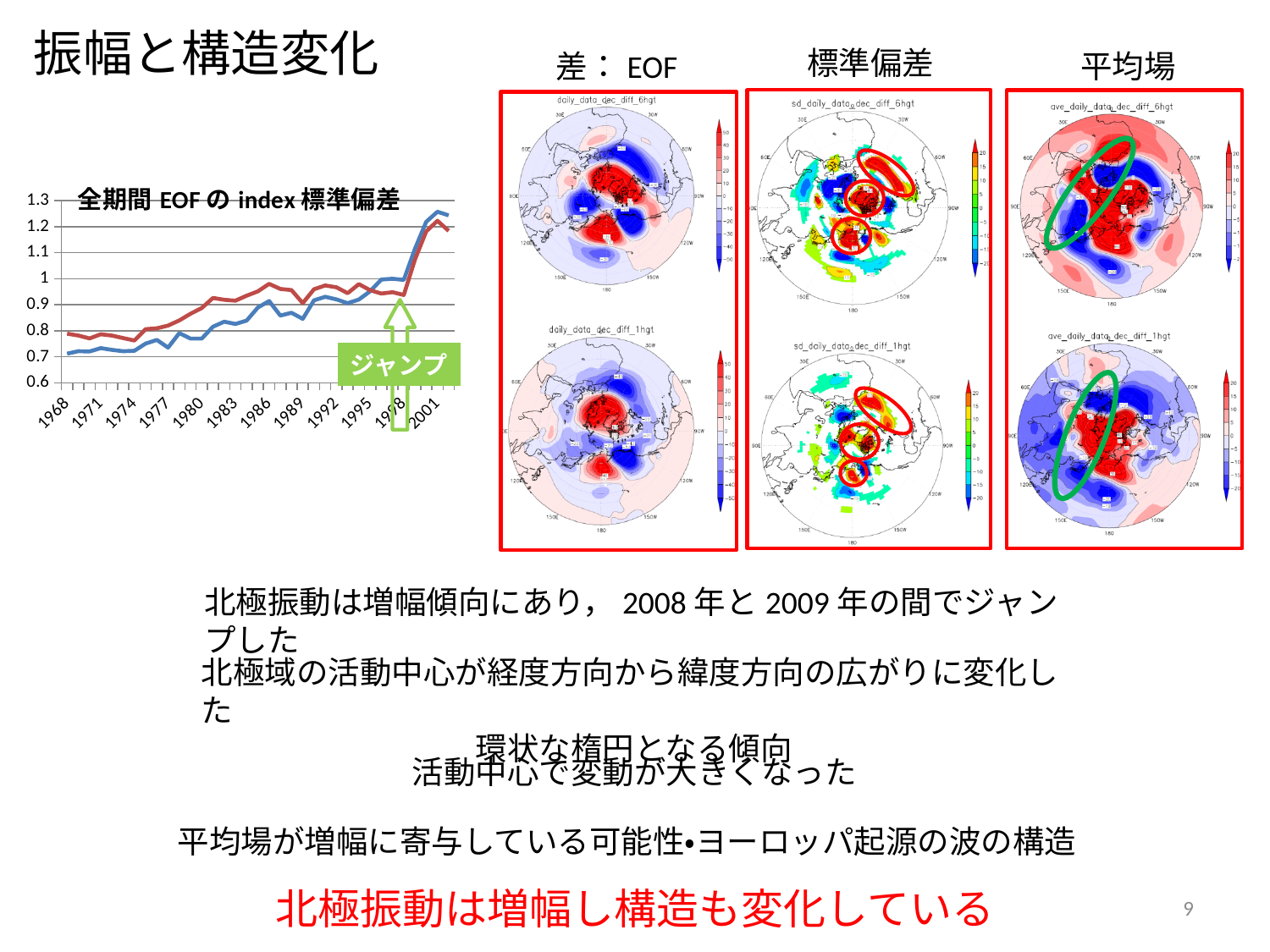
What is the lowest value shown on the y-axis of the line chart '全期間 EOF の index 標準偏差'? 0.6 How many year labels are shown on the x-axis of the line chart '全期間 EOF の index 標準偏差'? 12 In the line chart '全期間 EOF の index 標準偏差', is the value of the blue line at 2001 greater or less than 1.2? greater What is the title of the line chart on the left of the slide? 全期間 EOF の index 標準偏差 In the line chart '全期間 EOF の index 標準偏差', which line has the higher value at 1980, the red line or the blue line? red line In the line chart '全期間 EOF の index 標準偏差', is the value of the blue line at 1989 greater or less than 0.9? less In the line chart '全期間 EOF の index 標準偏差', is the value of the blue line at 1968 greater or less than 0.8? less What type of chart is the chart titled '全期間 EOF の index 標準偏差'? line chart In the line chart '全期間 EOF の index 標準偏差', do the values generally rise or fall from 1968 to 2001? rise In the line chart '全期間 EOF の index 標準偏差', which line has the higher value at 1968, the red line or the blue line? red line How many lines (data series) are plotted in the line chart '全期間 EOF の index 標準偏差'? 2